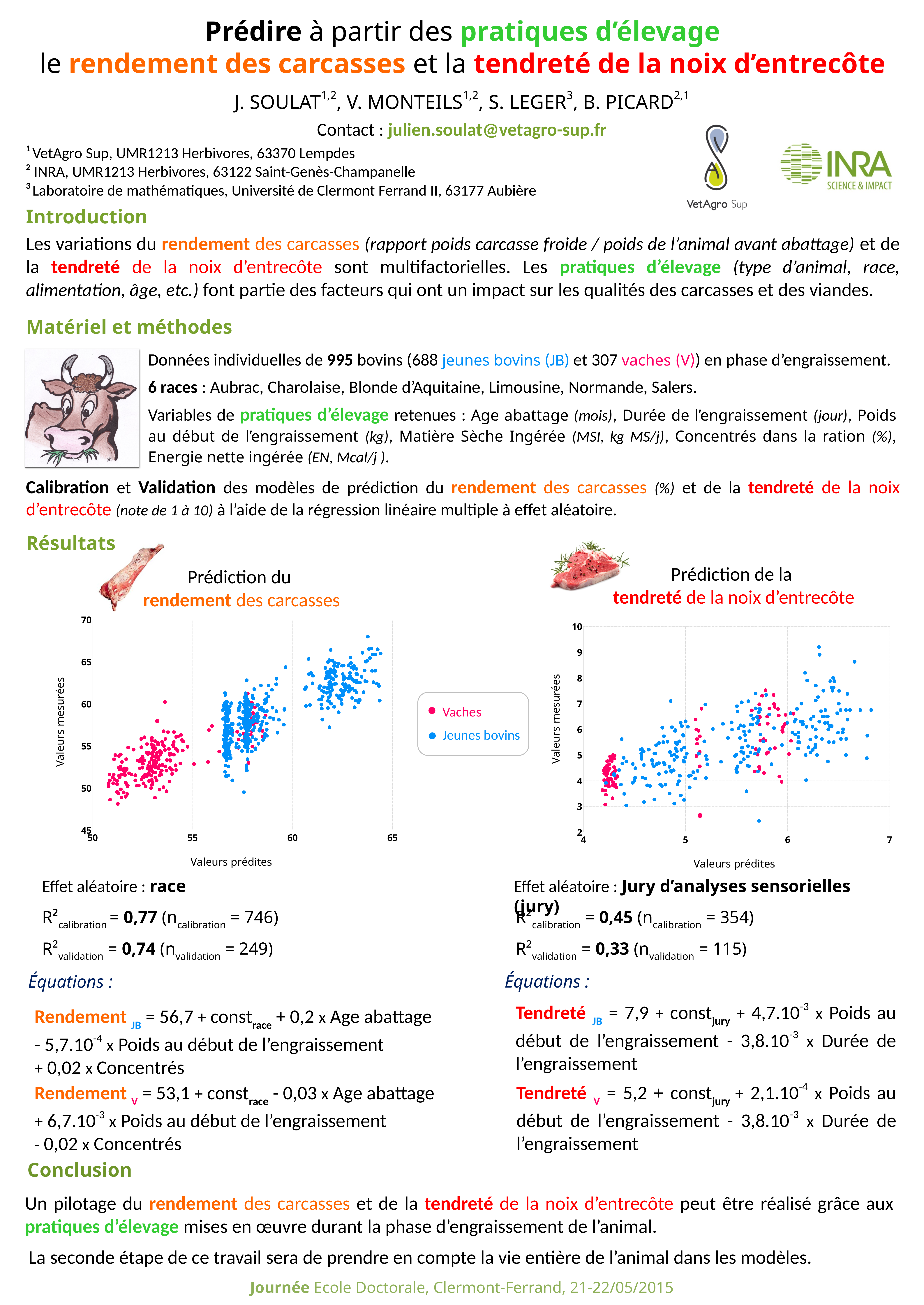
In the 'Prédiction de la tendreté de la noix d'entrecôte' chart, do the measured values rise or fall as the predicted values increase along the x axis? rise What kind of chart is the 'Prédiction du rendement des carcasses' chart? scatter chart In the 'Prédiction du rendement des carcasses' chart, do the measured values rise or fall as the predicted values increase along the x axis? rise How many series does the legend between the two charts list? 2 What are the two series named in the legend? Vaches, Jeunes bovins In the 'Prédiction du rendement des carcasses' chart, which series has the higher predicted and measured values overall, Vaches or Jeunes bovins? Jeunes bovins What kind of chart is the 'Prédiction de la tendreté de la noix d'entrecôte' chart? scatter chart In the 'Prédiction du rendement des carcasses' chart, what is the label of the x axis? Valeurs prédites